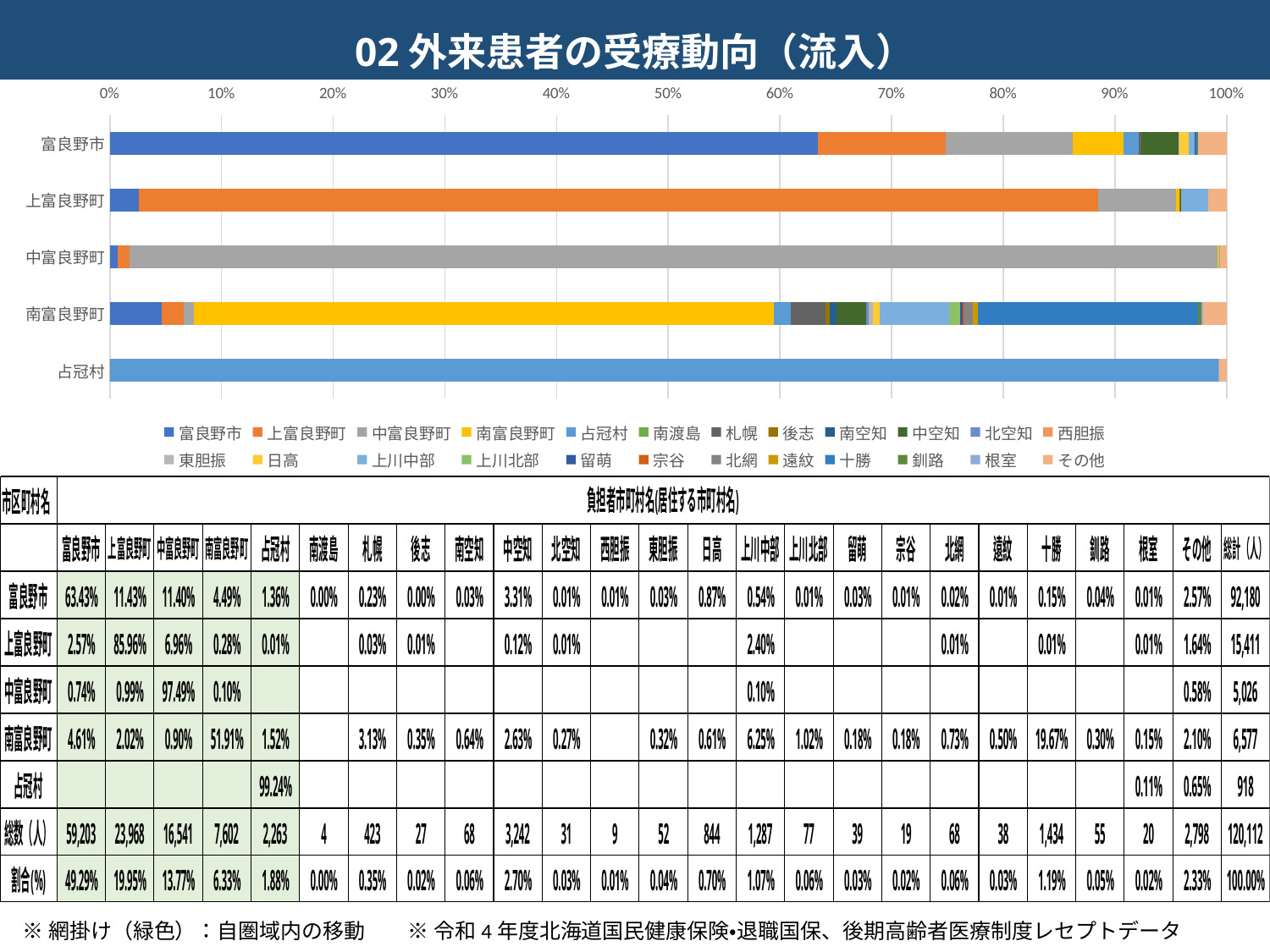
What is the difference between the 富良野市 own-municipality share (63.43%) and the 南富良野町 own-municipality share (51.91%)? 11.52% How many municipalities (categories) are plotted on the y axis of the chart? 5 In the 占冠村 bar, is the 占冠村 segment greater or less than 90%? greater According to the table, what share of 南富良野町 residents' outpatient visits went to 十勝? 19.67% According to the table, what share of 中富良野町 residents' outpatient visits went to 中富良野町? 97.49% According to the table, what share of 占冠村 residents' outpatient visits went to 占冠村? 99.24% In the 富良野市 bar, is the 富良野市 segment greater or less than 60%? greater What kind of chart is shown on the slide? Stacked bar chart In the 上富良野町 bar, is the 上富良野町 segment greater or less than 80%? greater How many series does the chart legend list? 24 Which is larger: the share of 富良野市 residents visiting 富良野市 (63.43%) or the share of 南富良野町 residents visiting 南富良野町 (51.91%)? 富良野市 What colour represents the 富良野市 series in the chart legend? Blue